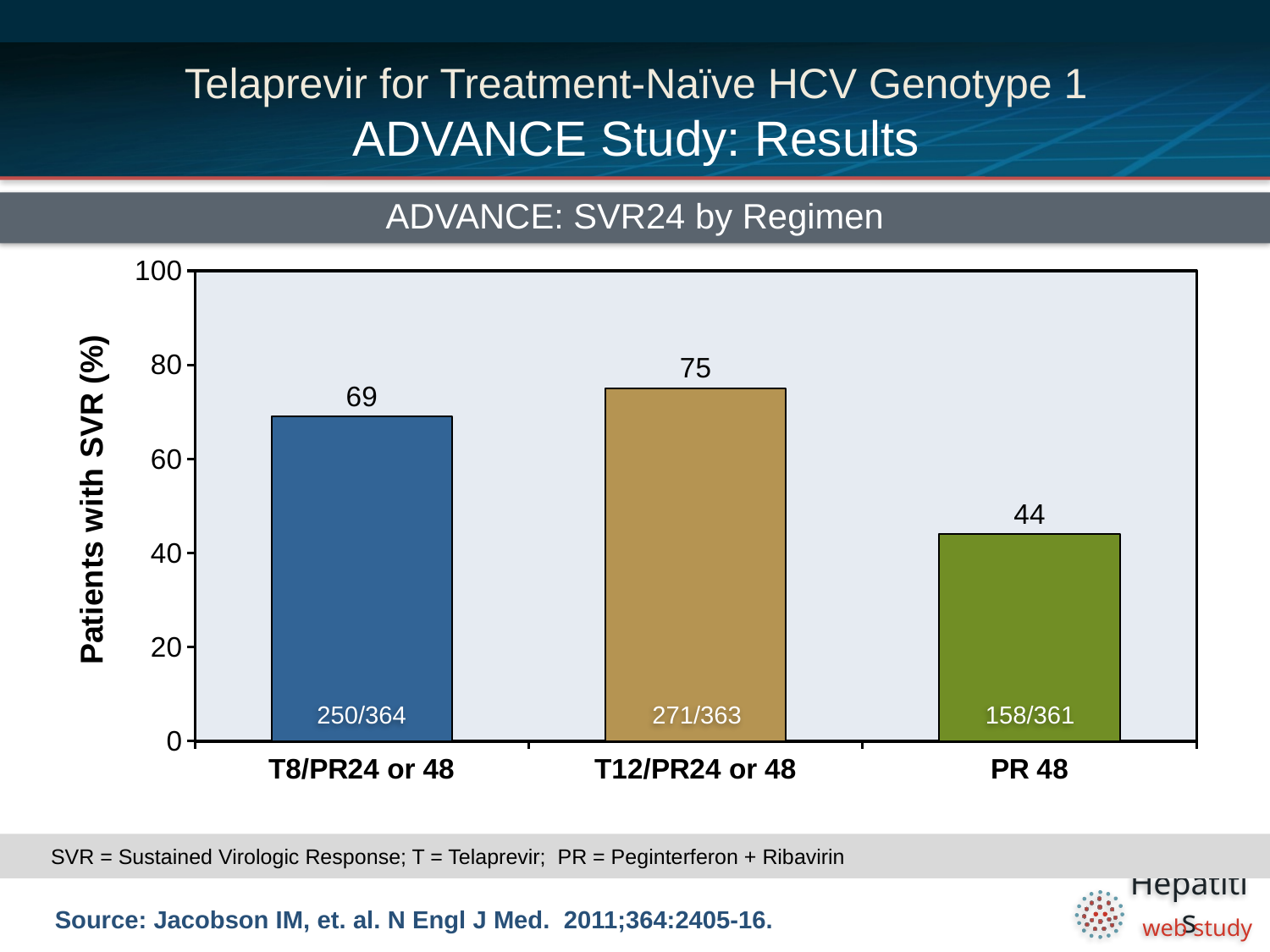
What is the SVR rate (%) for the T12/PR24 or 48 regimen? 75 Which regimen has the lowest SVR rate? PR 48 What is the SVR rate (%) for the T8/PR24 or 48 regimen? 69 What is the SVR rate (%) for the PR 48 regimen? 44 Which regimen has the highest SVR rate? T12/PR24 or 48 What type of chart is shown on the slide? Bar chart What is the difference in SVR rate (percentage points) between T12/PR24 or 48 and PR 48? 31 What is the difference in SVR rate (percentage points) between T12/PR24 or 48 and T8/PR24 or 48? 6 Which regimen has a higher SVR rate, T8/PR24 or 48 or PR 48? T8/PR24 or 48 What fraction of patients is shown inside the bar for the PR 48 regimen? 158/361 What is the title of the chart? ADVANCE: SVR24 by Regimen How many regimens are shown in the chart? 3